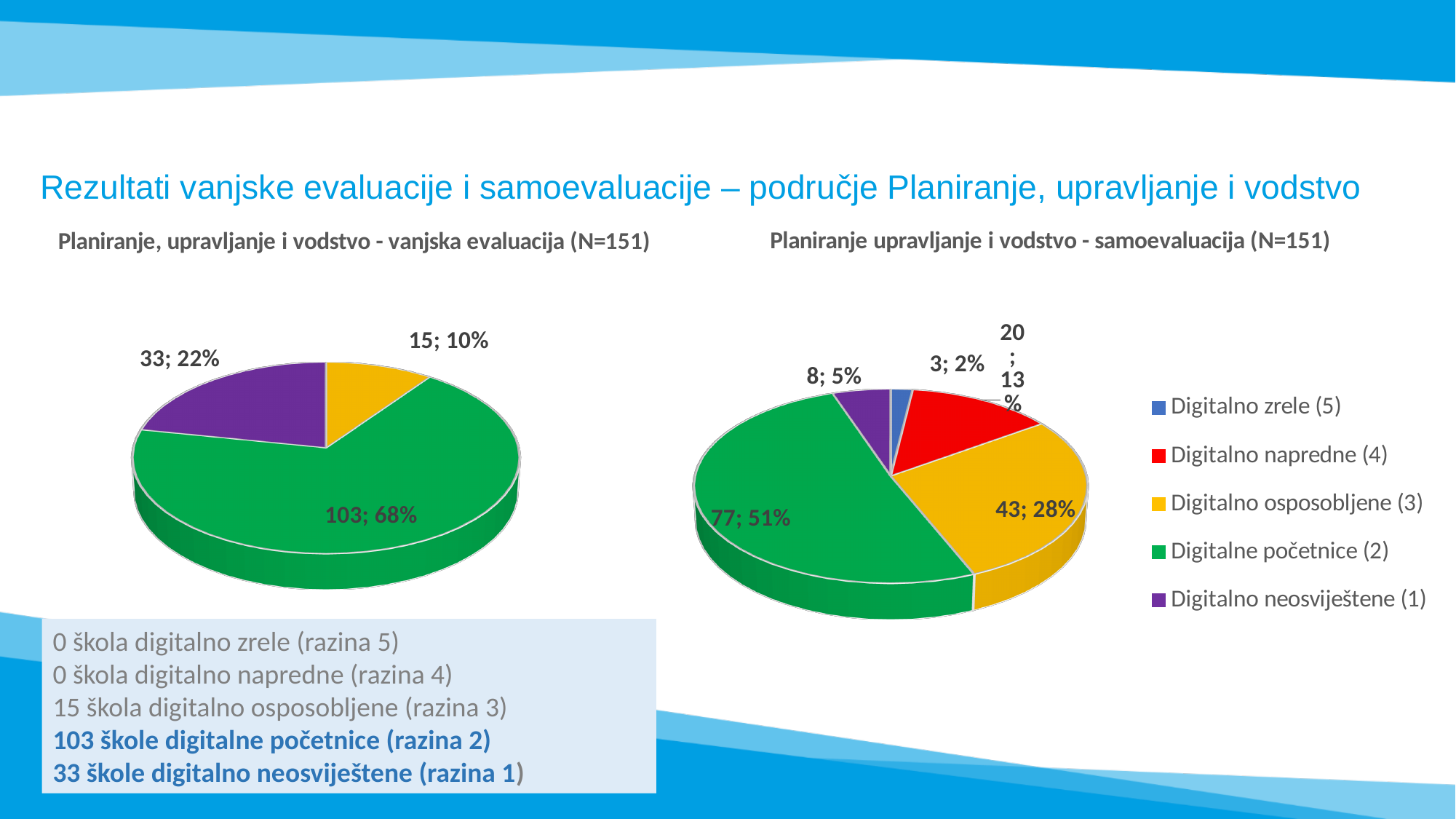
In the 'samoevaluacija' chart, how many schools are Digitalno osposobljene (3)? 43 What is the difference between the number of Digitalne početnice (2) schools in the 'vanjska evaluacija' chart and in the 'samoevaluacija' chart? 26 In the 'vanjska evaluacija' chart, what percentage share do Digitalno neosviještene (1) schools have? 22% What type of chart is used on this slide? Pie chart In the 'vanjska evaluacija' chart, how many schools are Digitalne početnice (2)? 103 In the 'vanjska evaluacija' chart, what is the value for Digitalno osposobljene (3)? 15 How many entries does the legend list? 5 Which is larger: the number of Digitalno neosviještene (1) schools in the 'vanjska evaluacija' chart or in the 'samoevaluacija' chart? vanjska evaluacija In the 'samoevaluacija' chart, what percentage share do Digitalne početnice (2) schools have? 51% In the 'vanjska evaluacija' chart, which category has the largest slice? Digitalne početnice (2) In the 'samoevaluacija' chart, which category has the smallest slice? Digitalno zrele (5) What colour represents Digitalno napredne (4) in the legend? Red